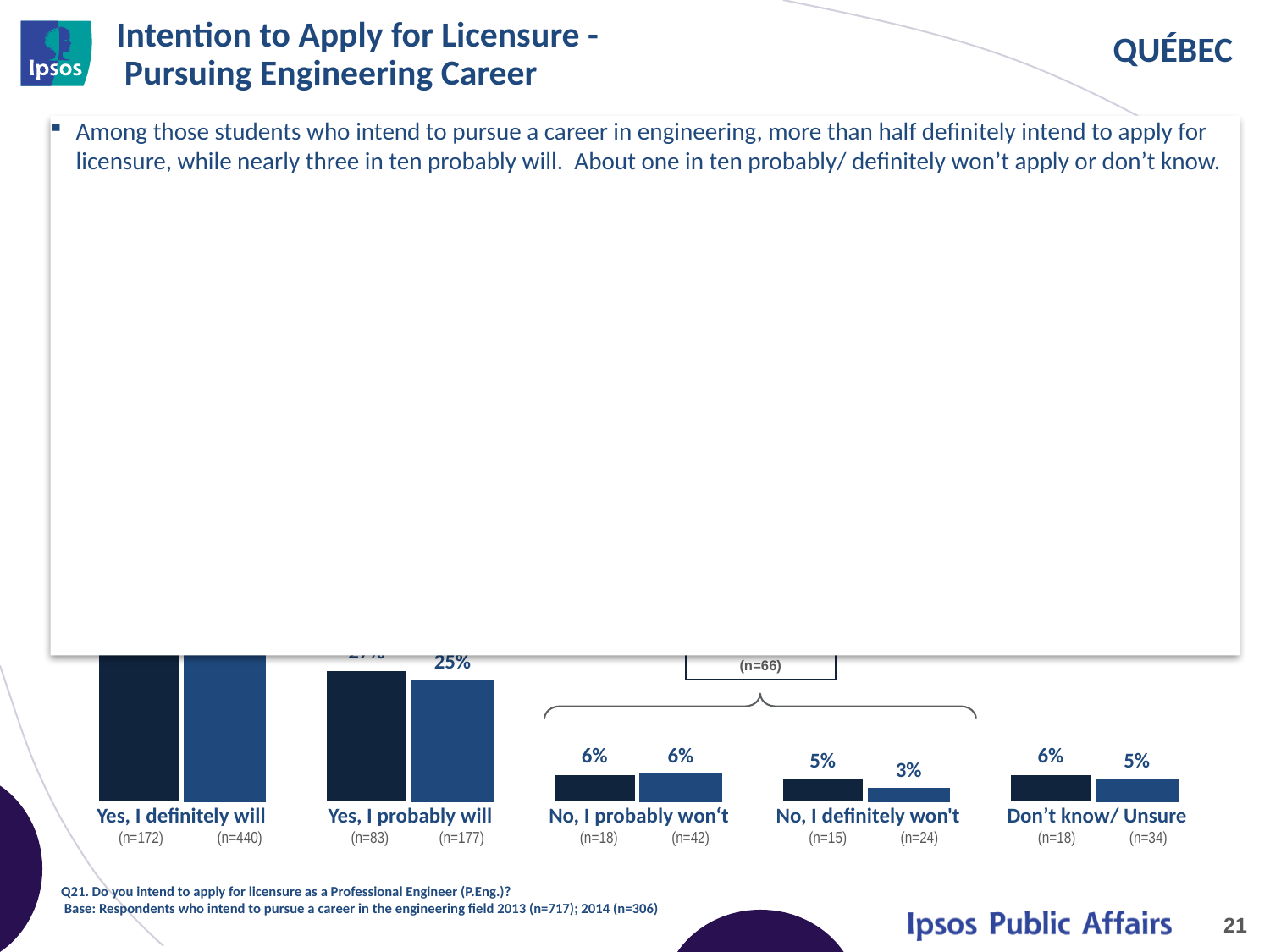
What kind of chart is shown on the slide? bar chart What sample size is shown in the box above the bracket spanning the three right-hand categories? (n=66) Which category has the lowest value among the lighter blue bars? No, I definitely won't What is the value of the lighter blue bar for "Yes, I probably will"? 25% What is the value of the lighter blue bar for "No, I definitely won't"? 3% What is the value of the dark navy bar for "No, I probably won't"? 6% What is the value of the lighter blue bar for "Don't know/ Unsure"? 5% For "Don't know/ Unsure", which bar is larger, the dark navy bar or the lighter blue bar? the dark navy bar What is the value of the dark navy bar for "No, I definitely won't"? 5% For "No, I definitely won't", what is the difference between the dark navy bar and the lighter blue bar? 2 percentage points What is the value of the dark navy bar for "Don't know/ Unsure"? 6% How many response categories are shown along the x axis of the chart? 5